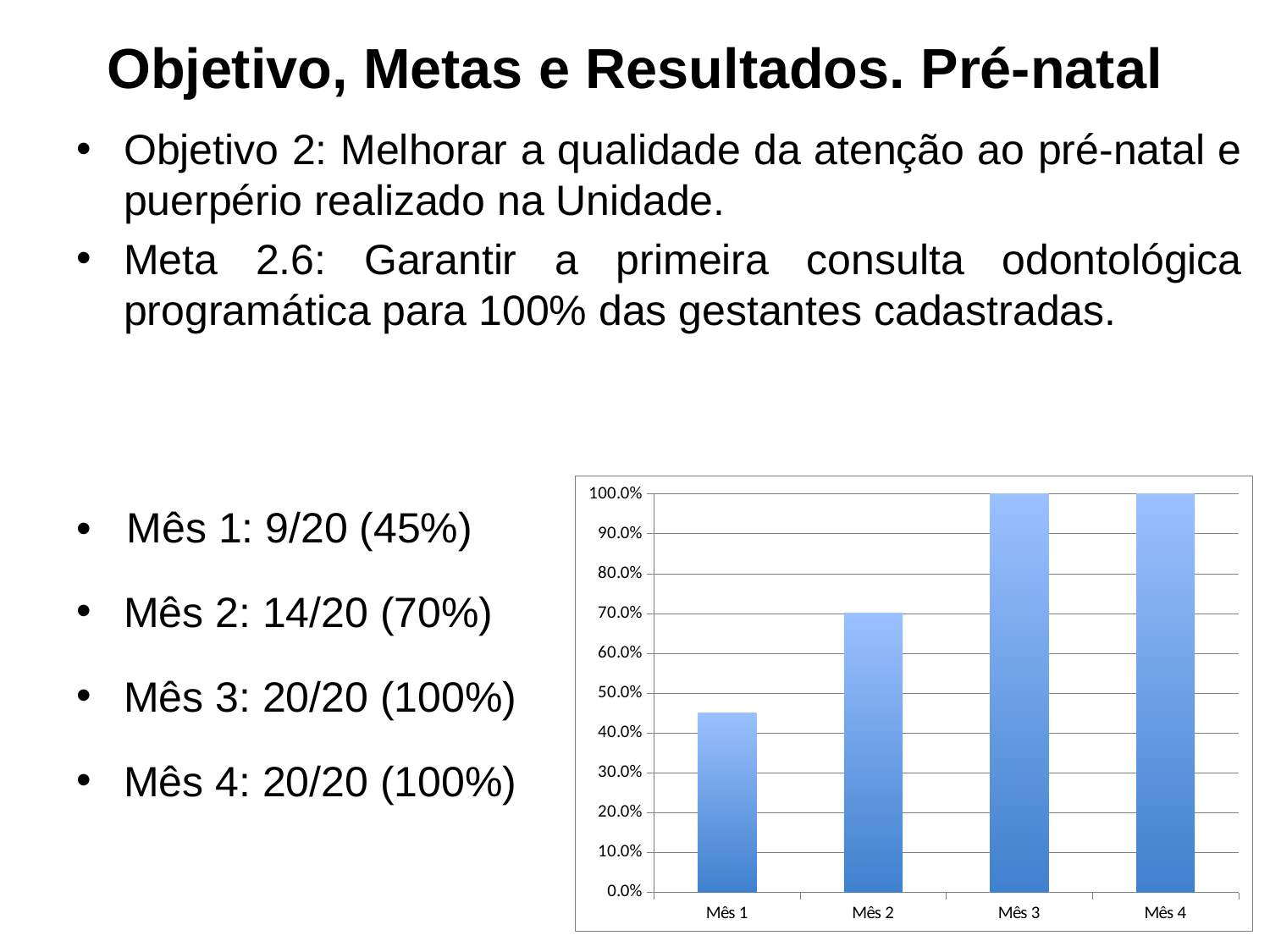
Which is larger, the value for Mês 1 or the value for Mês 2? Mês 2 How many months (categories) are plotted on the chart? 4 What is the highest tick label on the vertical axis of the chart? 100.0% What is the value for Mês 1 on the chart? 45% What kind of chart is shown on the slide? bar chart Which month has the lowest bar on the chart? Mês 1 What is the value for Mês 2 on the chart? 70% Is the value for Mês 1 greater or less than 50.0%? less Which months reach the highest value on the chart? Mês 3 and Mês 4 Do the values rise or fall from Mês 1 to Mês 4? rise What is the value for Mês 3 on the chart? 100% What is the difference between the values for Mês 3 and Mês 2? 30 percentage points